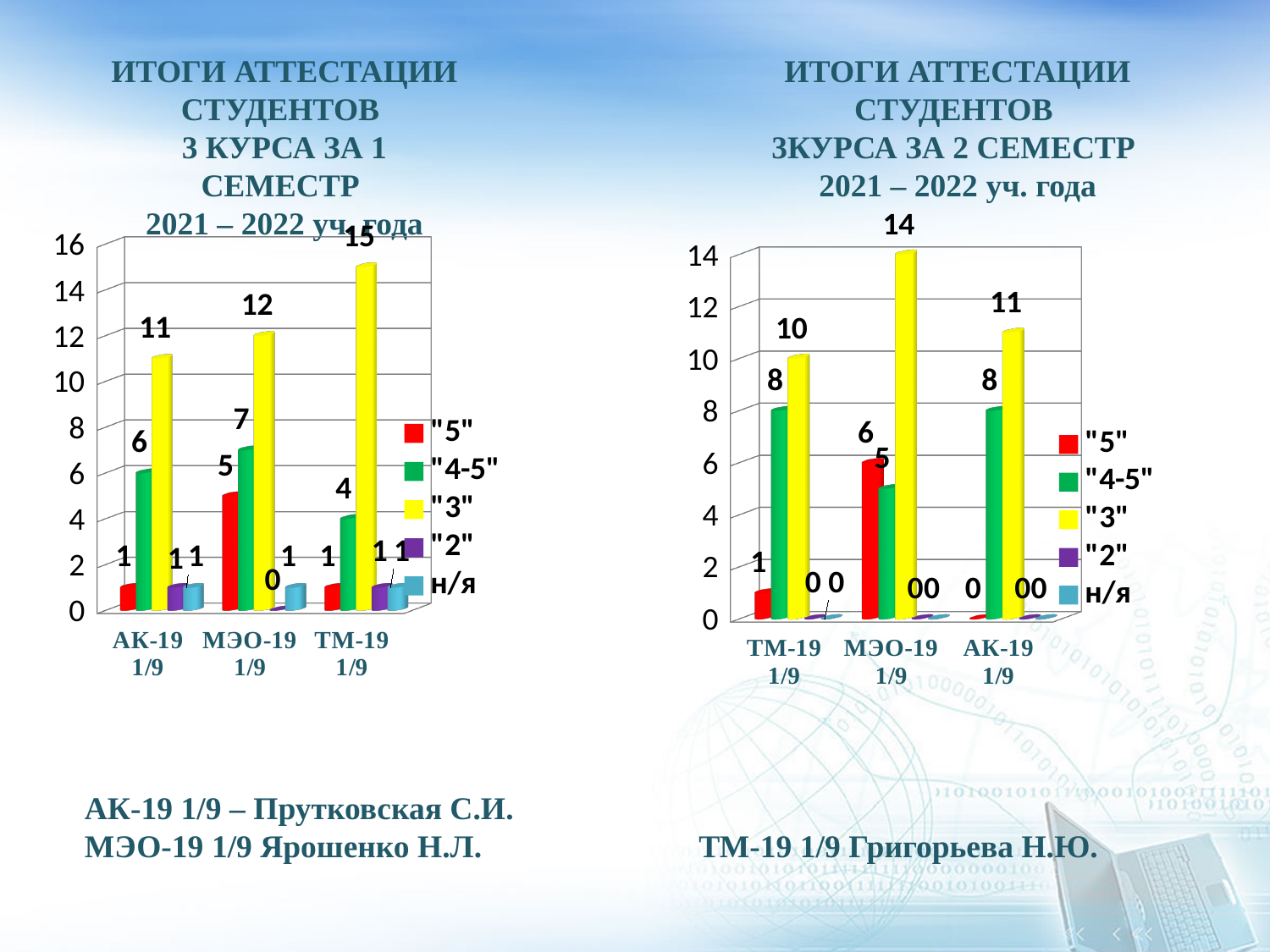
In the right chart (2nd semester), what is the value of the "5" series for МЭО-19 1/9? 6 In the left chart (1st semester), which group has the highest value in the "3" series? ТМ-19 1/9 In the right chart (2nd semester), what is the value of the "3" series for МЭО-19 1/9? 14 How many series does the legend of the right chart (2nd semester) list? 5 How many groups are shown on the x axis of the left chart (1st semester)? 3 In the left chart (1st semester), what is the value of the "4-5" series for МЭО-19 1/9? 7 In the right chart (2nd semester), which is larger: the "4-5" value for ТМ-19 1/9 or the "4-5" value for МЭО-19 1/9? ТМ-19 1/9 What kind of chart is the left chart (1st semester)? Bar chart In the right chart (2nd semester), which group has the lowest value in the "3" series? ТМ-19 1/9 In the left chart (1st semester), what is the difference between the "3" values for ТМ-19 1/9 and АК-19 1/9? 4 In the left chart (1st semester), what is the value of the "3" series for ТМ-19 1/9? 15 In the right chart (2nd semester), what colour represents the "3" series? Yellow